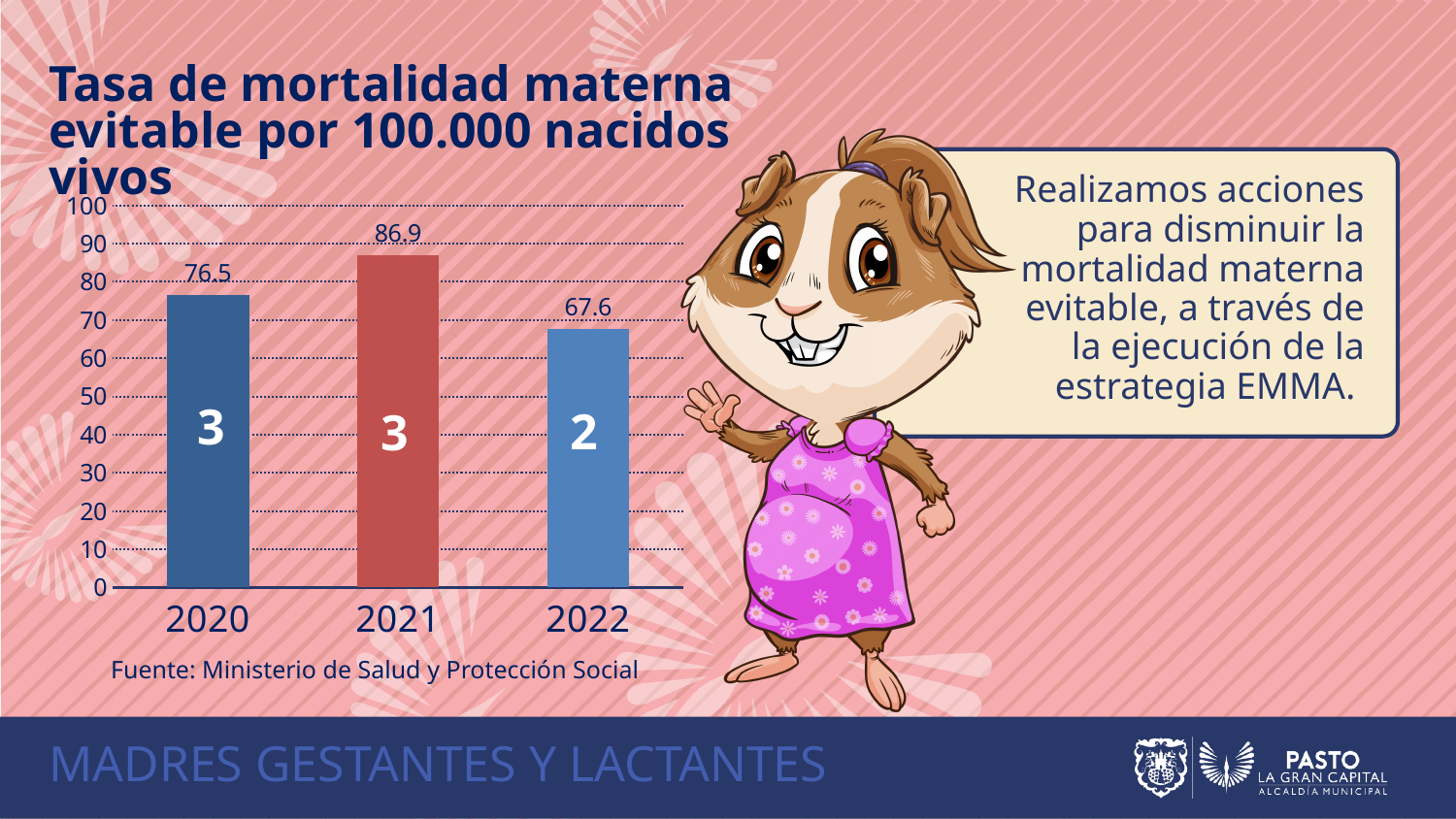
Is the value for 2021 greater or less than 80? greater What is the value shown for 2021? 86.9 What is the value shown for 2020? 76.5 What is the value shown for 2022? 67.6 Which is larger, the value for 2020 or the value for 2022? 2020 Which year has the highest value? 2021 What number is printed inside the bar for 2022? 2 What is the difference between the values for 2021 and 2020? 10.4 How many years are shown on the x axis? 3 What is the difference between the values for 2021 and 2022? 19.3 What kind of chart is shown on the slide? bar chart Which year has the lowest value? 2022